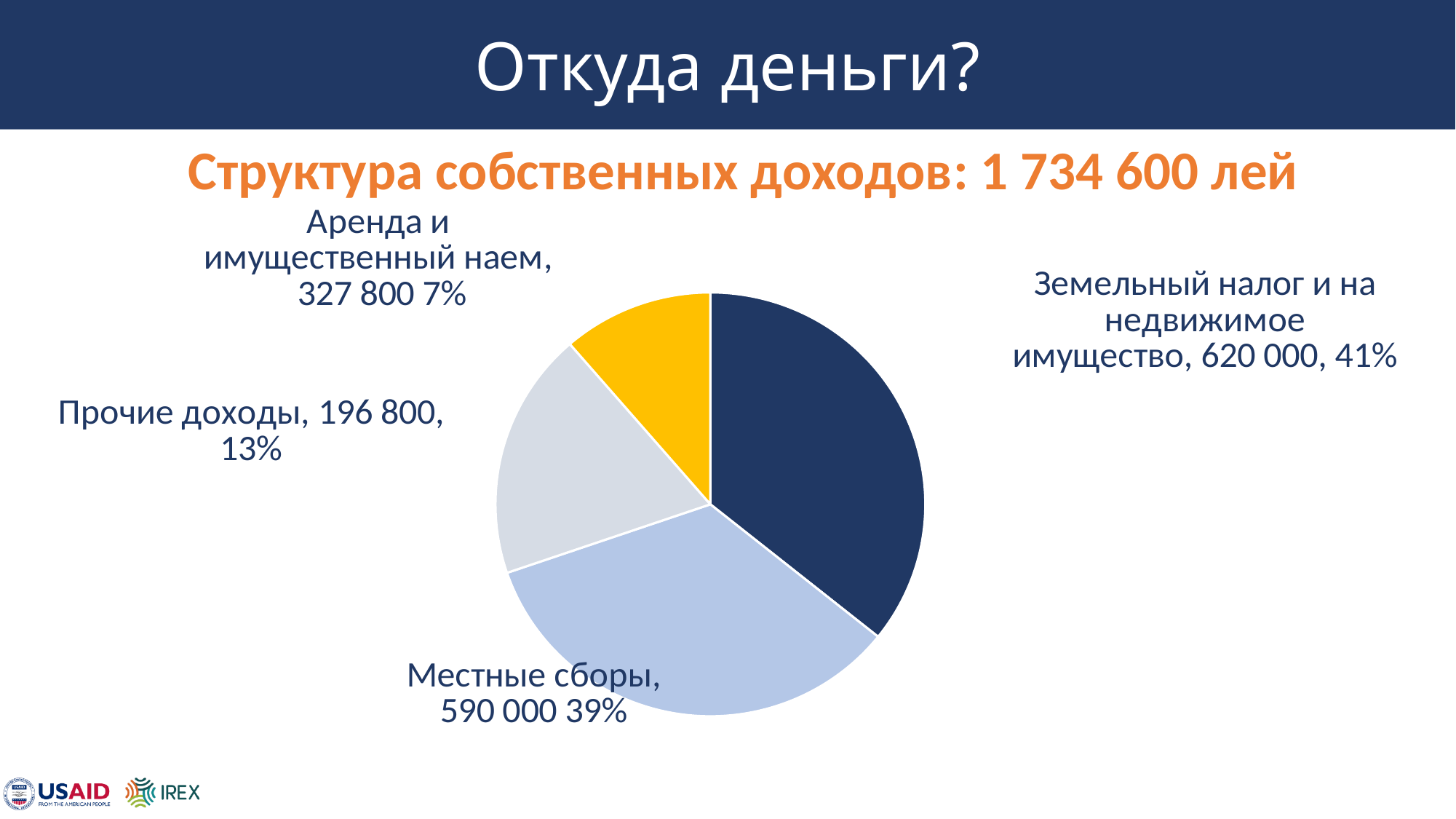
What value is shown for Местные сборы? 590 000 What kind of chart is shown on the slide? Pie chart What value is shown for Прочие доходы? 196 800 What is the difference between the values for Земельный налог и на недвижимое имущество and Местные сборы? 30 000 What value is shown for Аренда и имущественный наем? 327 800 What percentage share of the pie is Прочие доходы? 13% Which category has the largest share of the pie? Земельный налог и на недвижимое имущество What value is shown for Земельный налог и на недвижимое имущество? 620 000 What percentage share of the pie is Местные сборы? 39% What total amount is stated in the chart title? 1 734 600 лей How many slices does the pie chart have? 4